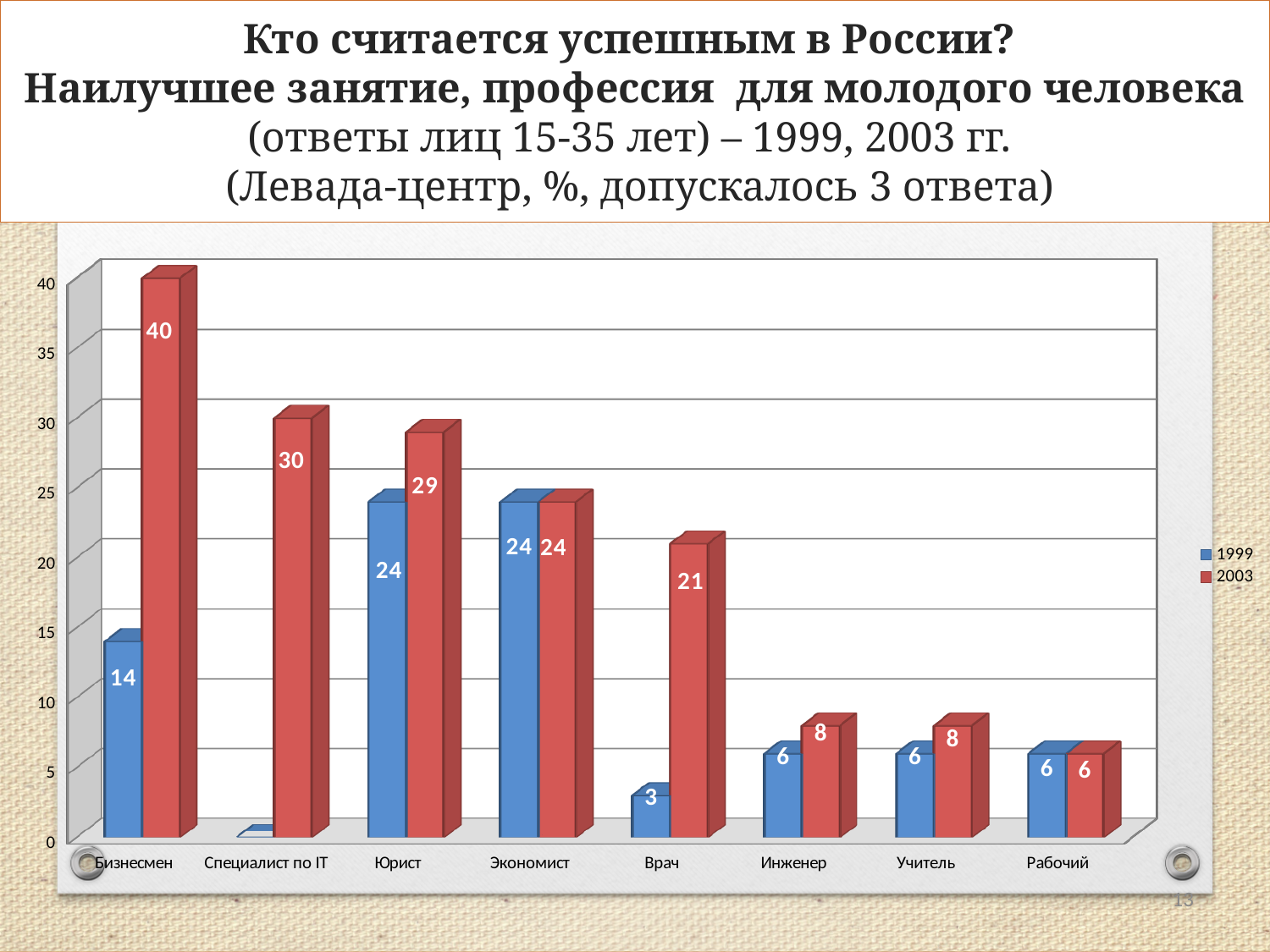
Is the 2003 value for Специалист по IT greater or less than 25? greater What is the difference between the 2003 and 1999 values for Бизнесмен? 26 Which is larger for Врач: the 1999 value or the 2003 value? 2003 How many categories are shown on the x axis? 8 What is the value for Юрист in the 1999 series? 24 Which category has the highest value in the 2003 series? Бизнесмен Which category has the lowest value in the 2003 series? Рабочий What is the value for Бизнесмен in the 2003 series? 40 What is the value for Врач in the 2003 series? 21 What is the value for Бизнесмен in the 1999 series? 14 What kind of chart is shown on the slide? bar chart How many series does the legend list? 2